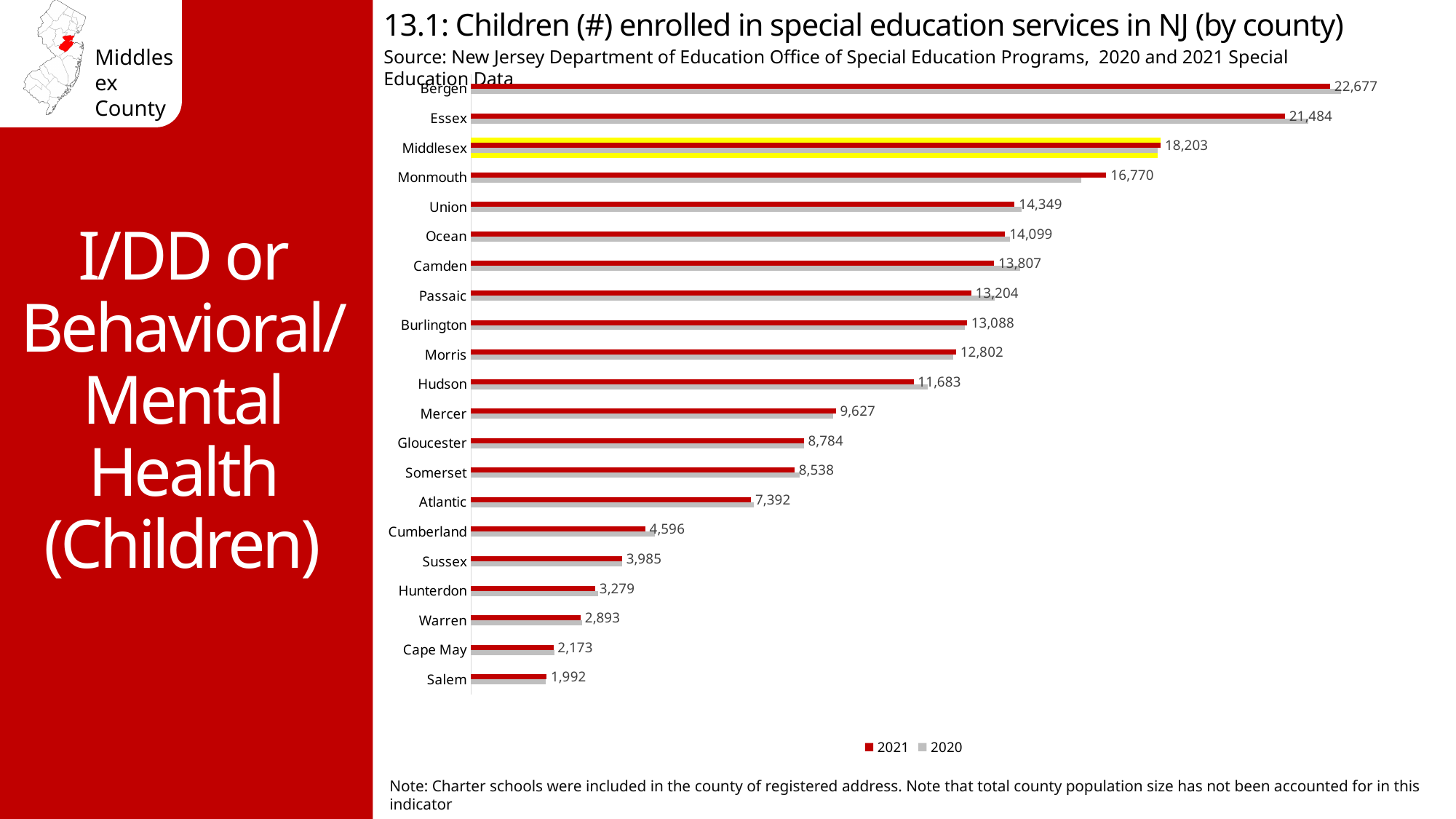
How many counties are shown in the chart? 21 What is the difference between the 2021 values for Bergen and Essex? 1,193 What is the 2021 value for Hudson County? 11,683 What kind of chart is shown on the slide? Bar chart Which county has the highest number of children enrolled in special education services in 2021? Bergen What is the difference between the 2021 values for Middlesex and Monmouth? 1,433 How many series does the legend list? 2 Which county has the lowest number of children enrolled in special education services in 2021? Salem Which county's bars are highlighted in yellow? Middlesex What is the 2021 value for Middlesex County? 18,203 What is the 2021 value for Cape May County? 2,173 Which county has a larger 2021 value, Mercer or Gloucester? Mercer